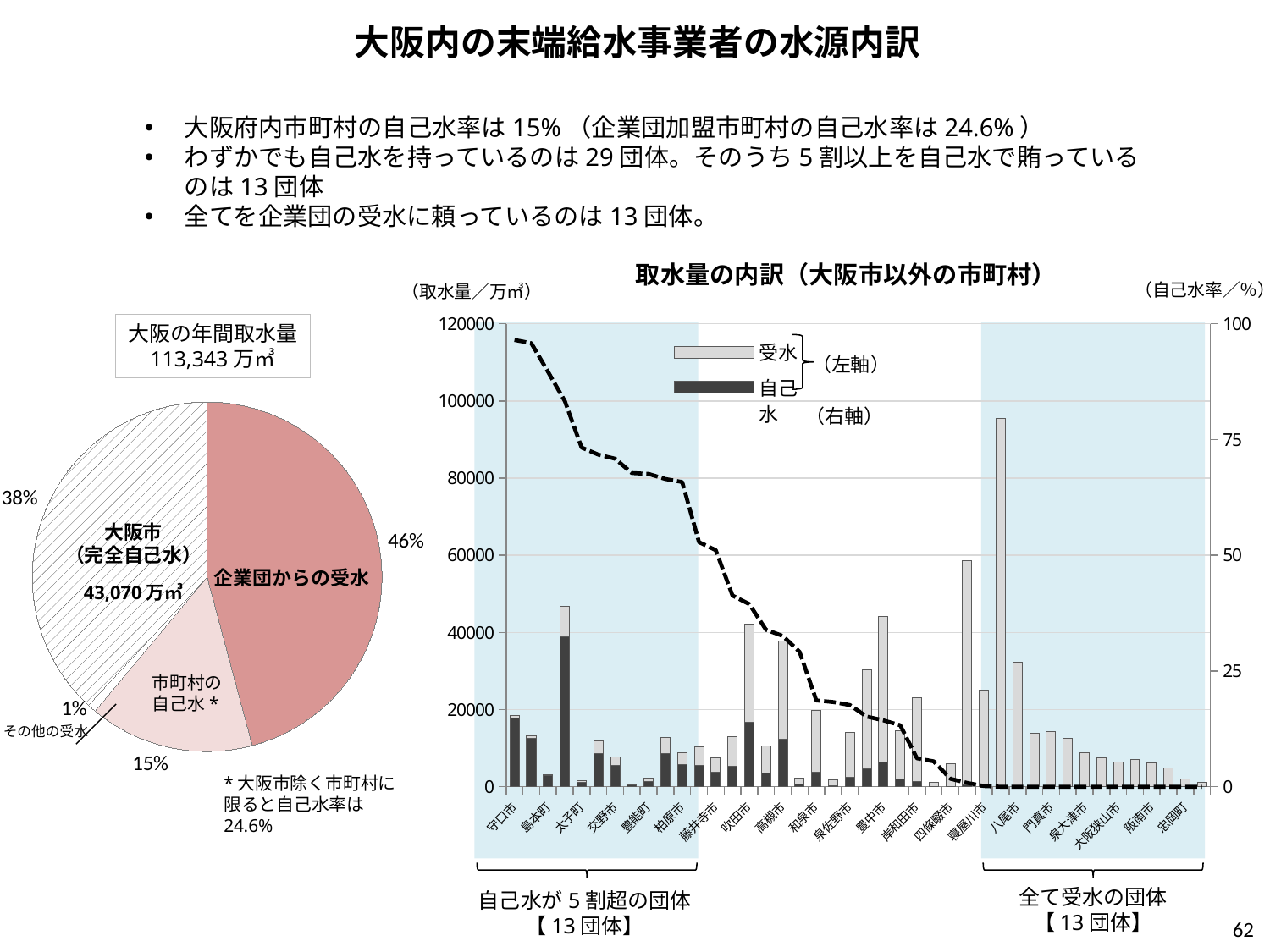
In the chart titled 取水量の内訳（大阪市以外の市町村）, is the bar for 豊中市 greater or less than 20000? greater In the chart titled 取水量の内訳（大阪市以外の市町村）, does the dashed line for 自己水率 rise or fall from left to right? fall In the pie chart on the left, which slice is larger: 企業団からの受水 or 市町村の自己水? 企業団からの受水 In the chart titled 取水量の内訳（大阪市以外の市町村）, is the bar for 八尾市 greater or less than 80000? less In the pie chart on the left, which slice is the smallest? その他の受水 In the pie chart on the left, what share does 大阪市（完全自己水） have? 38% In the pie chart on the left, what share does 企業団からの受水 have? 46% In the pie chart on the left, what is the total annual water intake for 大阪 shown in the label? 113,343万㎥ In the pie chart on the left, what is the value shown for 大阪市（完全自己水）? 43,070万㎥ What kind of chart is the chart on the left of the slide? pie chart In the pie chart on the left, what is the difference in percentage points between 企業団からの受水 and 大阪市（完全自己水）? 8